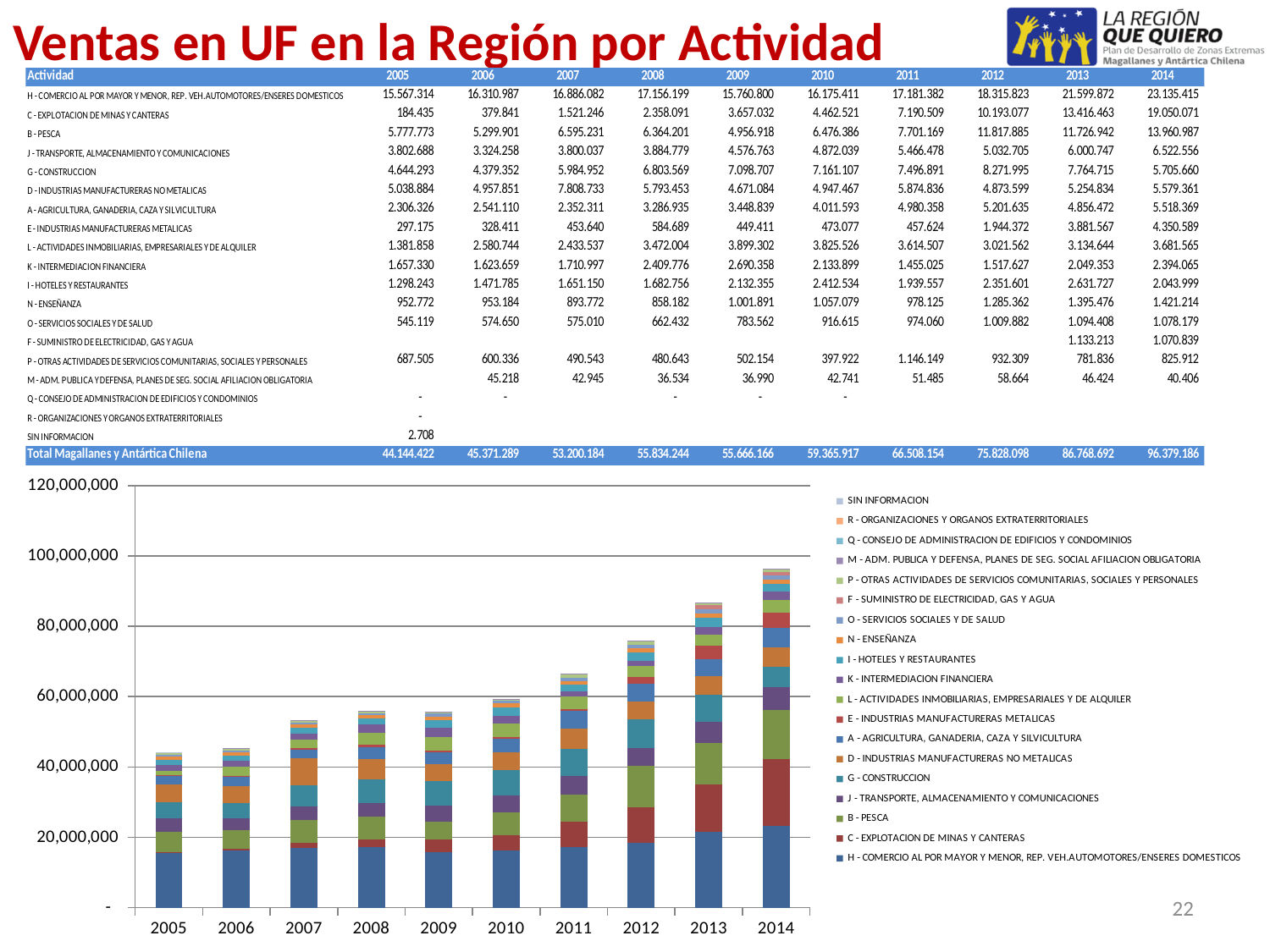
What kind of chart is shown at the bottom of the slide? Stacked bar chart Which stacked bar is taller, 2013 or 2010? 2013 Is the total stacked bar for 2012 greater or less than 80,000,000? less Do the total sales in the chart generally rise or fall from 2005 to 2014? rise Which activity is listed last (at the bottom) in the chart's legend? H - COMERCIO AL POR MAYOR Y MENOR, REP. VEH.AUTOMOTORES/ENSERES DOMESTICOS How many series does the chart's legend list? 19 Which year has the tallest stacked bar in the chart? 2014 According to the total row of the table, what is the total of the stacked bar for 2014 (Total Magallanes y Antártica Chilena)? 96.379.186 Is the total stacked bar for 2009 greater or less than 60,000,000? less How many years (categories) are shown along the x axis of the chart? 10 Is the total stacked bar for 2005 greater or less than 40,000,000? greater